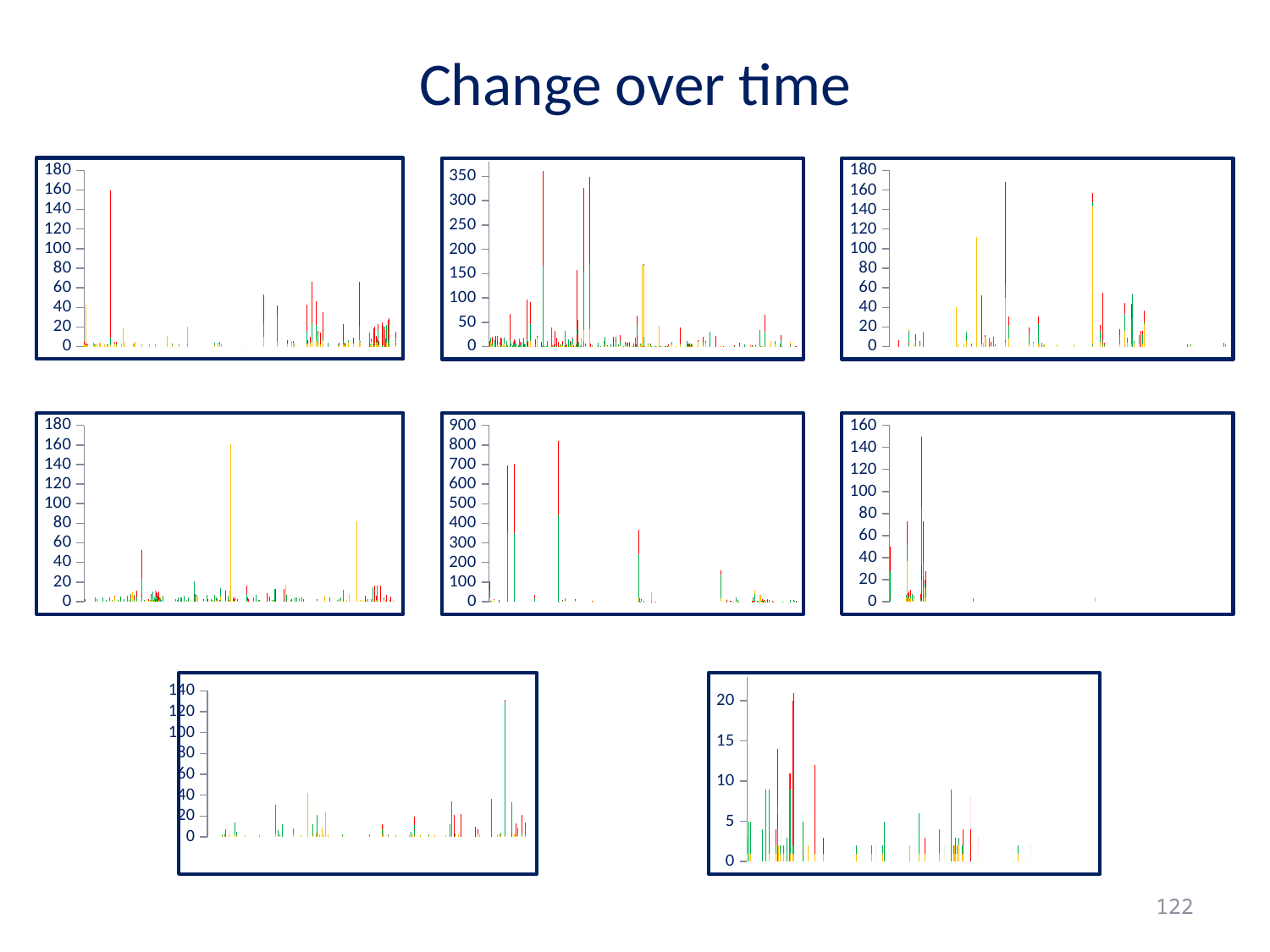
In the bottom-right chart, is the tallest bar greater or less than 15? greater What is the highest value labelled on the y axis of the middle chart in the middle row? 900 In the top-left chart, is the tallest bar greater or less than 140? greater What kind of chart is the top-left chart on the slide? bar chart In the middle-left chart, is the tallest bar greater or less than 140? greater How many charts are shown on the slide? 8